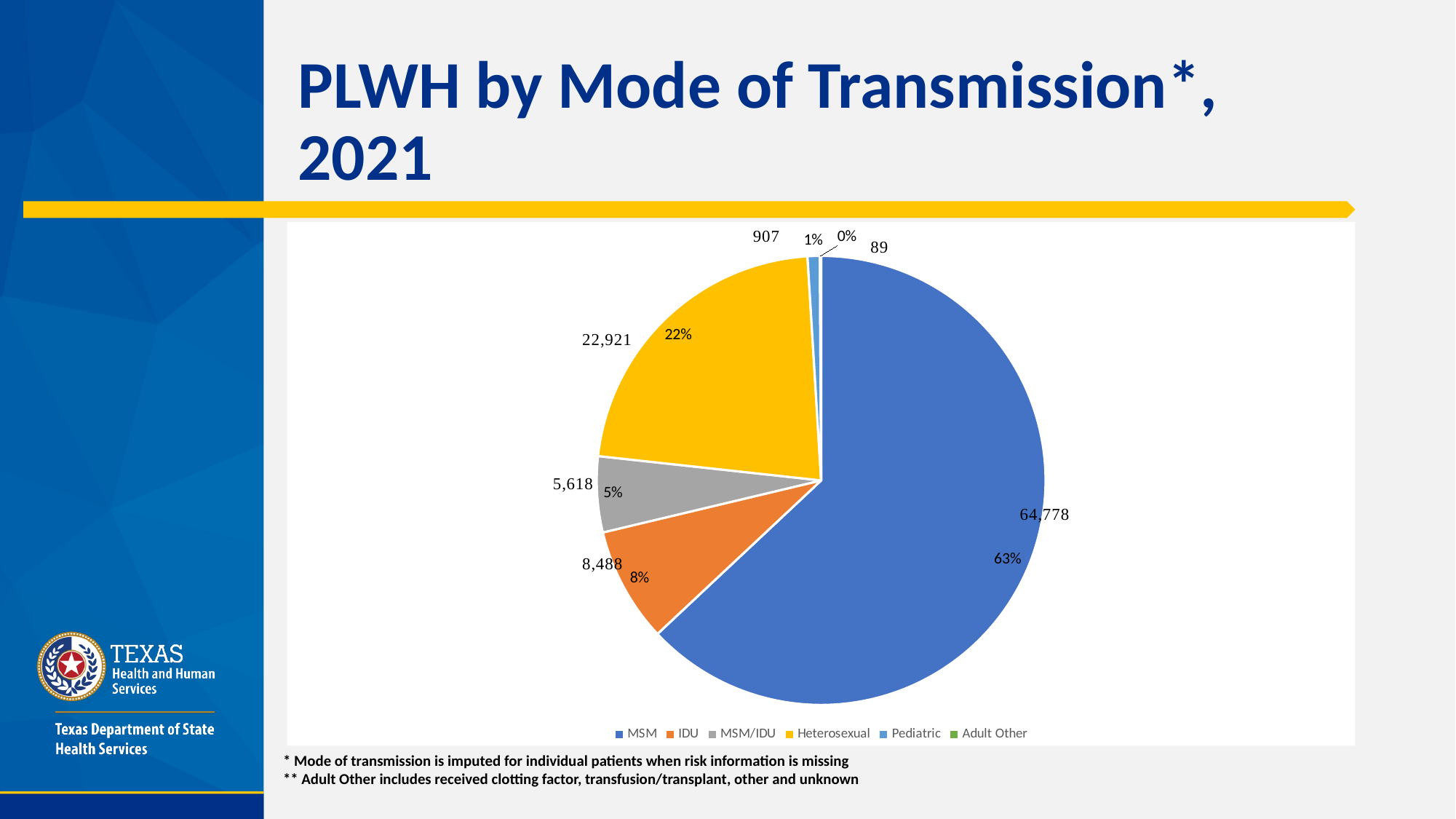
What is the value for IDU? 8,488 What is the value for MSM/IDU? 5,618 What type of chart is shown on the slide? pie chart What is the difference between the values for Heterosexual and IDU? 14,433 Which is larger, the value for IDU or the value for MSM/IDU? IDU How many categories does the legend list? 6 Which mode of transmission has the smallest slice? Adult Other What is the value for MSM? 64,778 What share of the pie does MSM represent? 63% What is the value for Heterosexual? 22,921 What share of the pie does Heterosexual represent? 22% Which mode of transmission has the largest slice? MSM